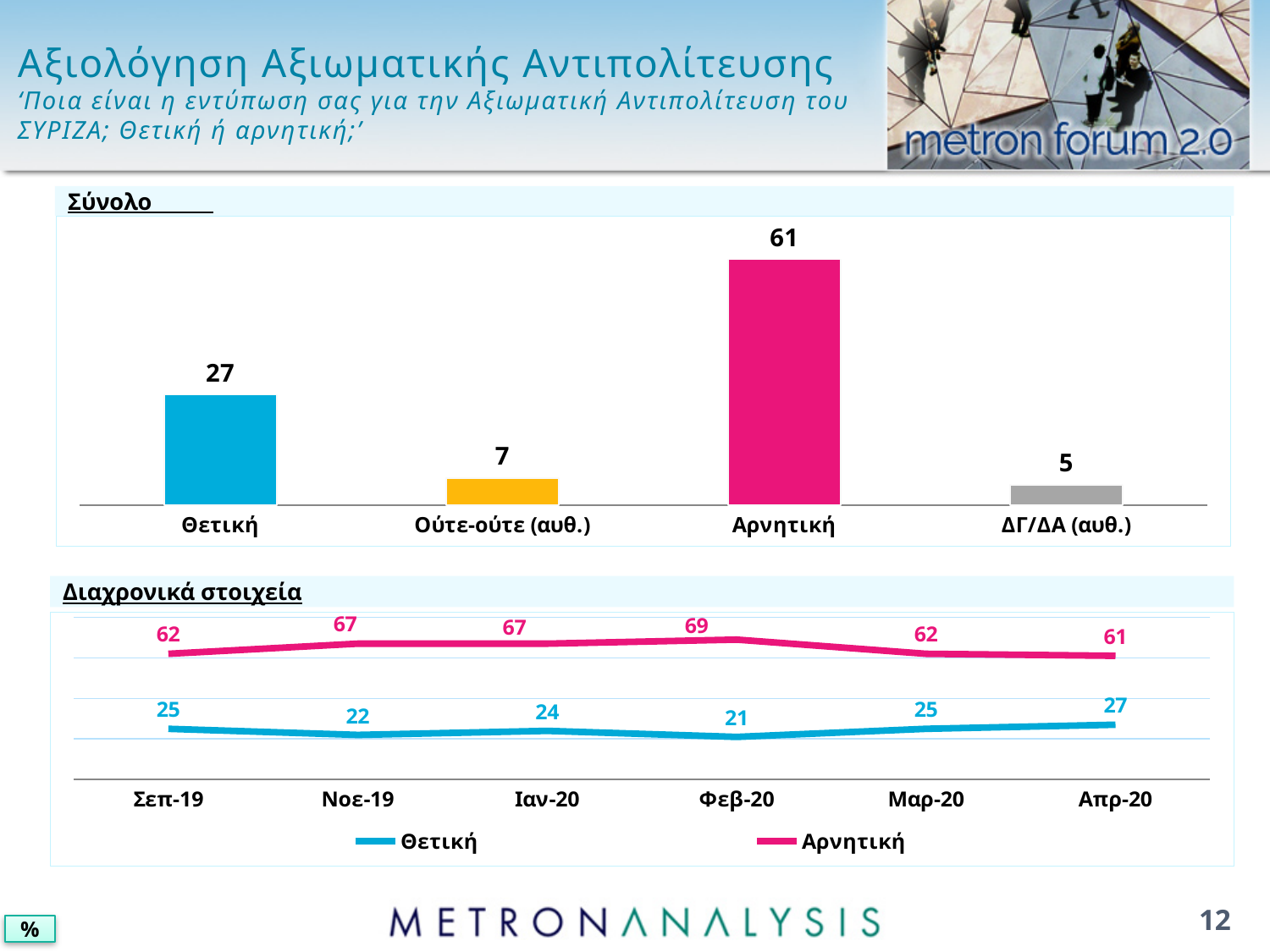
In the 'Σύνολο' bar chart, what is the value for Θετική? 27 In the 'Σύνολο' bar chart, what is the difference between Αρνητική and Θετική? 34 In the 'Διαχρονικά στοιχεία' line chart, what is the value for Θετική in Νοε-19? 22 In the 'Διαχρονικά στοιχεία' line chart, what is the value for Αρνητική in Φεβ-20? 69 In the 'Σύνολο' bar chart, how many categories are shown? 4 In the 'Σύνολο' bar chart, what is the value for Αρνητική? 61 In the 'Διαχρονικά στοιχεία' line chart, what is the difference between Αρνητική and Θετική in Σεπ-19? 37 In the 'Διαχρονικά στοιχεία' line chart, how many series does the legend list? 2 What kind of chart is the 'Σύνολο' chart? Bar chart In the 'Σύνολο' bar chart, which category has the lowest value? ΔΓ/ΔΑ (αυθ.) In the 'Διαχρονικά στοιχεία' line chart, in which period is Θετική lowest? Φεβ-20 In the 'Διαχρονικά στοιχεία' line chart, does the Αρνητική series rise or fall from Φεβ-20 to Απρ-20? Fall